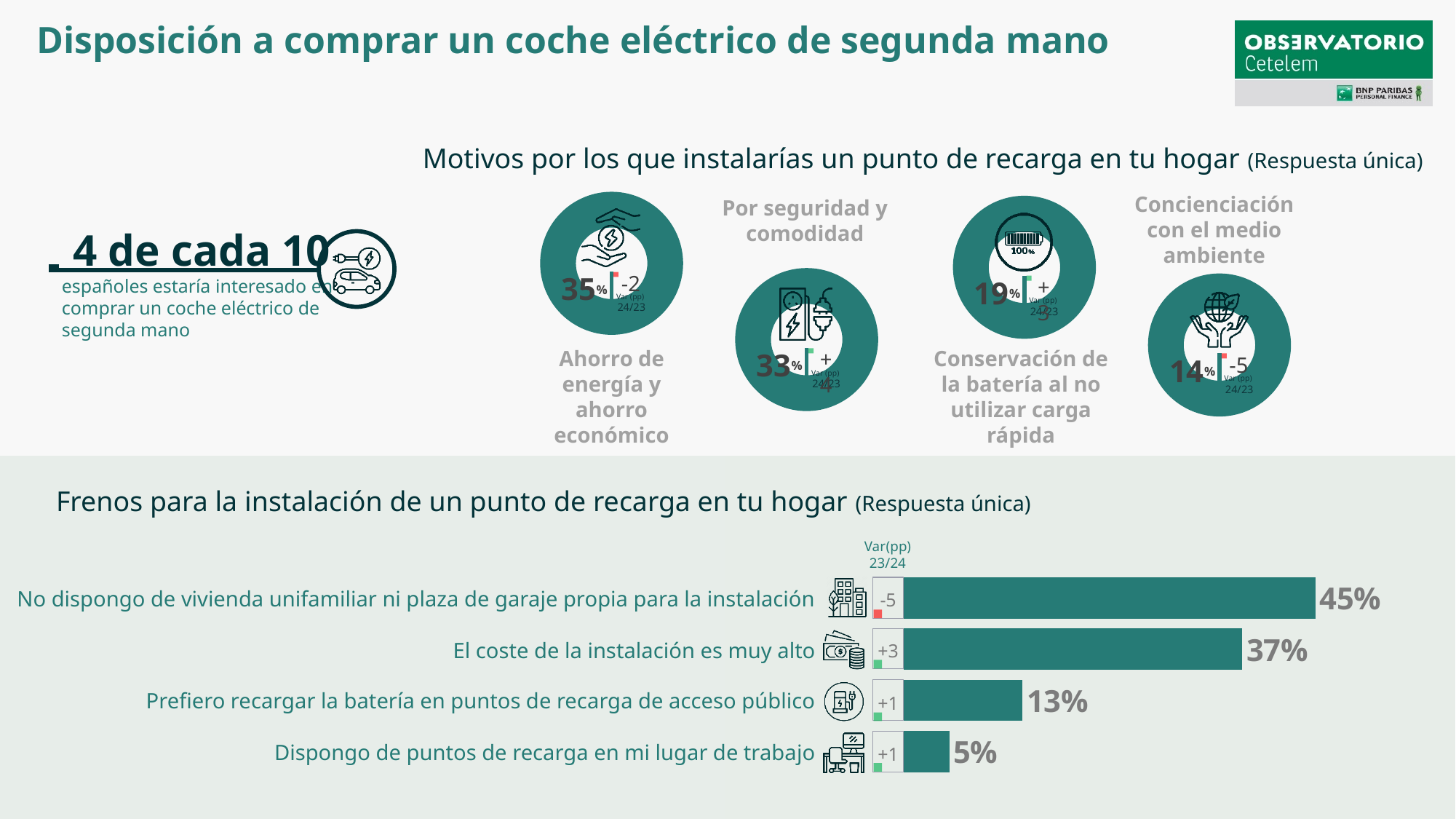
In the chart 'Frenos para la instalación de un punto de recarga en tu hogar', which category has the highest value? No dispongo de vivienda unifamiliar ni plaza de garaje propia para la instalación In the chart 'Frenos para la instalación de un punto de recarga en tu hogar', what is the difference between the values for 'No dispongo de vivienda unifamiliar ni plaza de garaje propia para la instalación' and 'El coste de la instalación es muy alto'? 8 percentage points In the chart 'Frenos para la instalación de un punto de recarga en tu hogar', what is the Var(pp) 23/24 value shown for 'No dispongo de vivienda unifamiliar ni plaza de garaje propia para la instalación'? -5 In the chart 'Frenos para la instalación de un punto de recarga en tu hogar', which category has the lowest value? Dispongo de puntos de recarga en mi lugar de trabajo In the top chart 'Motivos por los que instalarías un punto de recarga en tu hogar', which motive has the lowest value? Concienciación con el medio ambiente How many categories are shown in the chart 'Frenos para la instalación de un punto de recarga en tu hogar'? 4 What kind of chart is 'Frenos para la instalación de un punto de recarga en tu hogar'? Bar chart In the top chart 'Motivos por los que instalarías un punto de recarga en tu hogar', what is the value for 'Ahorro de energía y ahorro económico'? 35% In the chart 'Frenos para la instalación de un punto de recarga en tu hogar', what is the value for 'Dispongo de puntos de recarga en mi lugar de trabajo'? 5% In the chart 'Frenos para la instalación de un punto de recarga en tu hogar', which is larger: 'Prefiero recargar la batería en puntos de recarga de acceso público' or 'Dispongo de puntos de recarga en mi lugar de trabajo'? Prefiero recargar la batería en puntos de recarga de acceso público In the chart 'Frenos para la instalación de un punto de recarga en tu hogar', what is the value for 'El coste de la instalación es muy alto'? 37% In the top chart 'Motivos por los que instalarías un punto de recarga en tu hogar', what is the difference between 'Ahorro de energía y ahorro económico' and 'Por seguridad y comodidad'? 2 percentage points